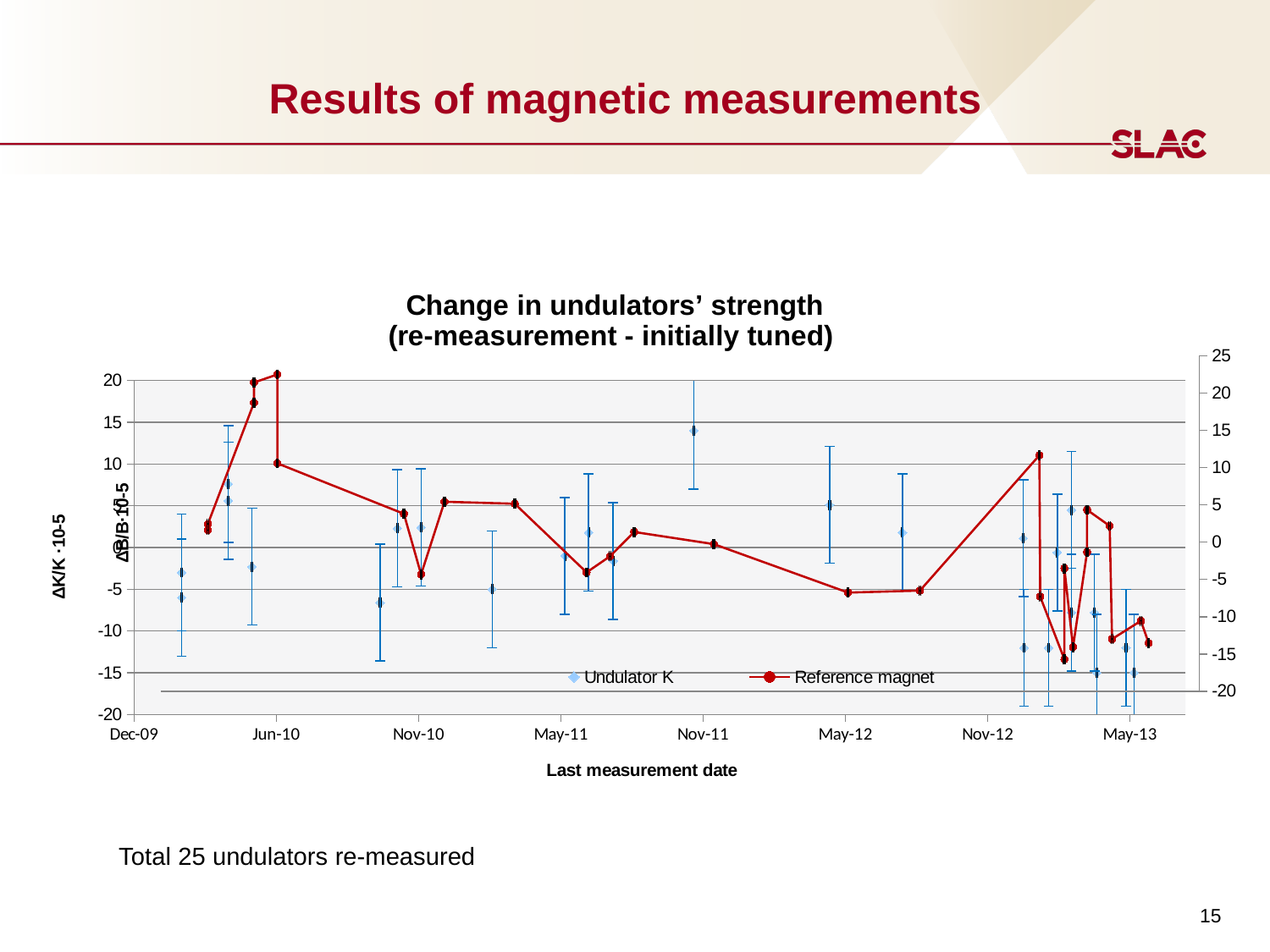
Is the highest value of the Reference magnet series greater or less than 15? greater What is the title of the chart? Change in undulators' strength (re-measurement - initially tuned) What are the two series named in the chart legend? Undulator K and Reference magnet Does the Reference magnet series generally rise or fall between Jun-10 and May-12? fall Is the Reference magnet value at Nov-10 greater or less than 0? less How many series does the chart legend list? 2 How many date labels are shown along the x axis of the chart? 8 Is the Reference magnet value at May-12 greater or less than 0? less Which series is drawn as a red line with circular markers? Reference magnet What kind of chart is shown on the slide? line chart Around which x-axis date does the Reference magnet series reach its highest value? Jun-10